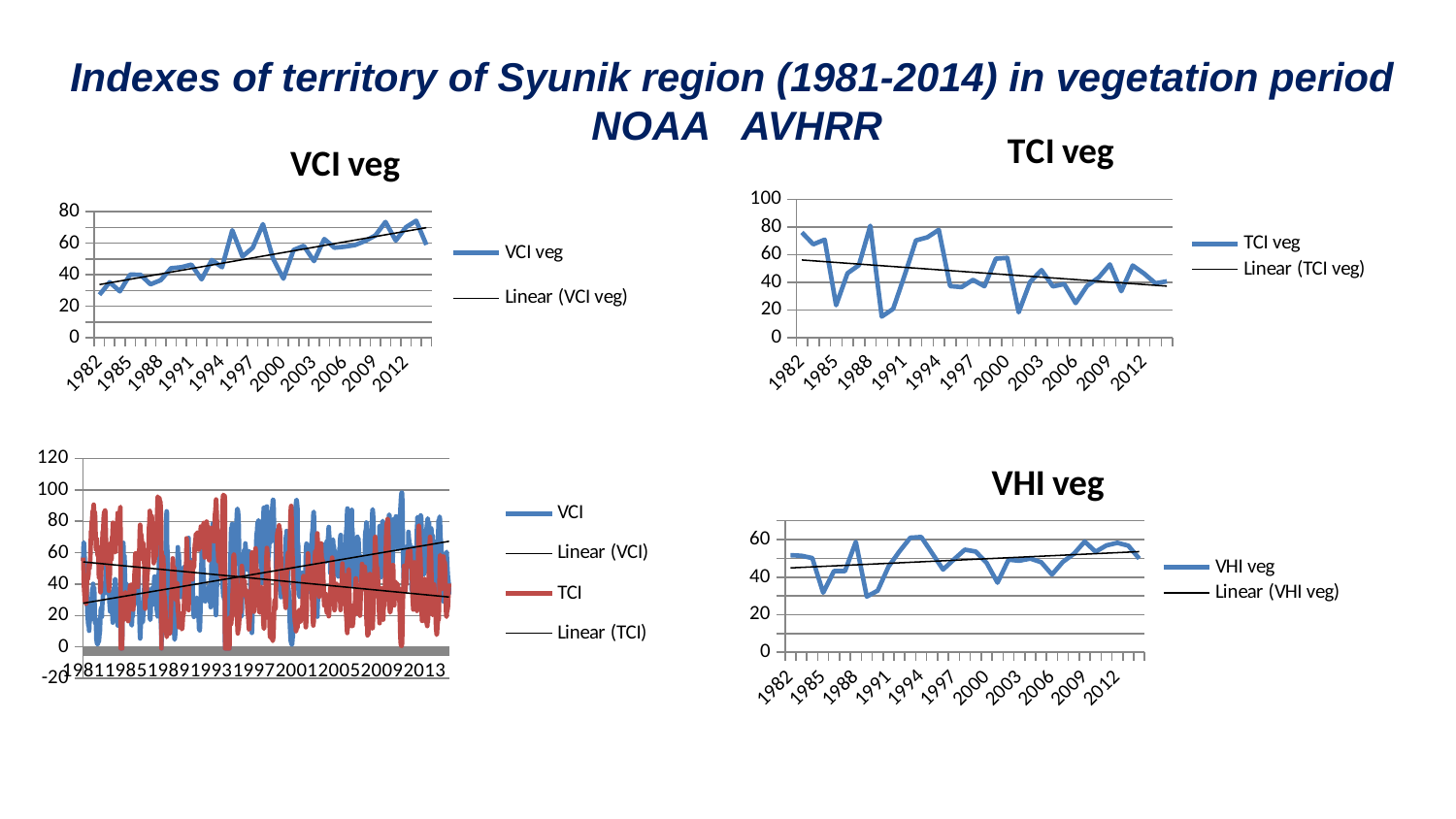
In the untitled chart at the bottom left, what colour is the TCI series line? red In the 'VCI veg' chart, is the value for 1982 greater or less than 40? less In the 'VHI veg' chart, does the linear trend line rise or fall from 1982 to 2014? rise What type of chart is the 'VCI veg' chart at the top left of the slide? line chart What is the highest value shown on the vertical axis of the 'TCI veg' chart? 100 In the 'TCI veg' chart, is the value for 1982 greater or less than 60? greater In the 'VHI veg' chart, is the value for 1982 greater or less than 40? greater How many entries does the legend of the untitled chart at the bottom left of the slide list? 4 In the 'VCI veg' chart, does the linear trend line rise or fall from 1982 to 2014? rise In the 'TCI veg' chart, does the linear trend line rise or fall across the years? fall How many entries does the legend of the 'VCI veg' chart list? 2 How many entries does the legend of the 'VHI veg' chart list? 2